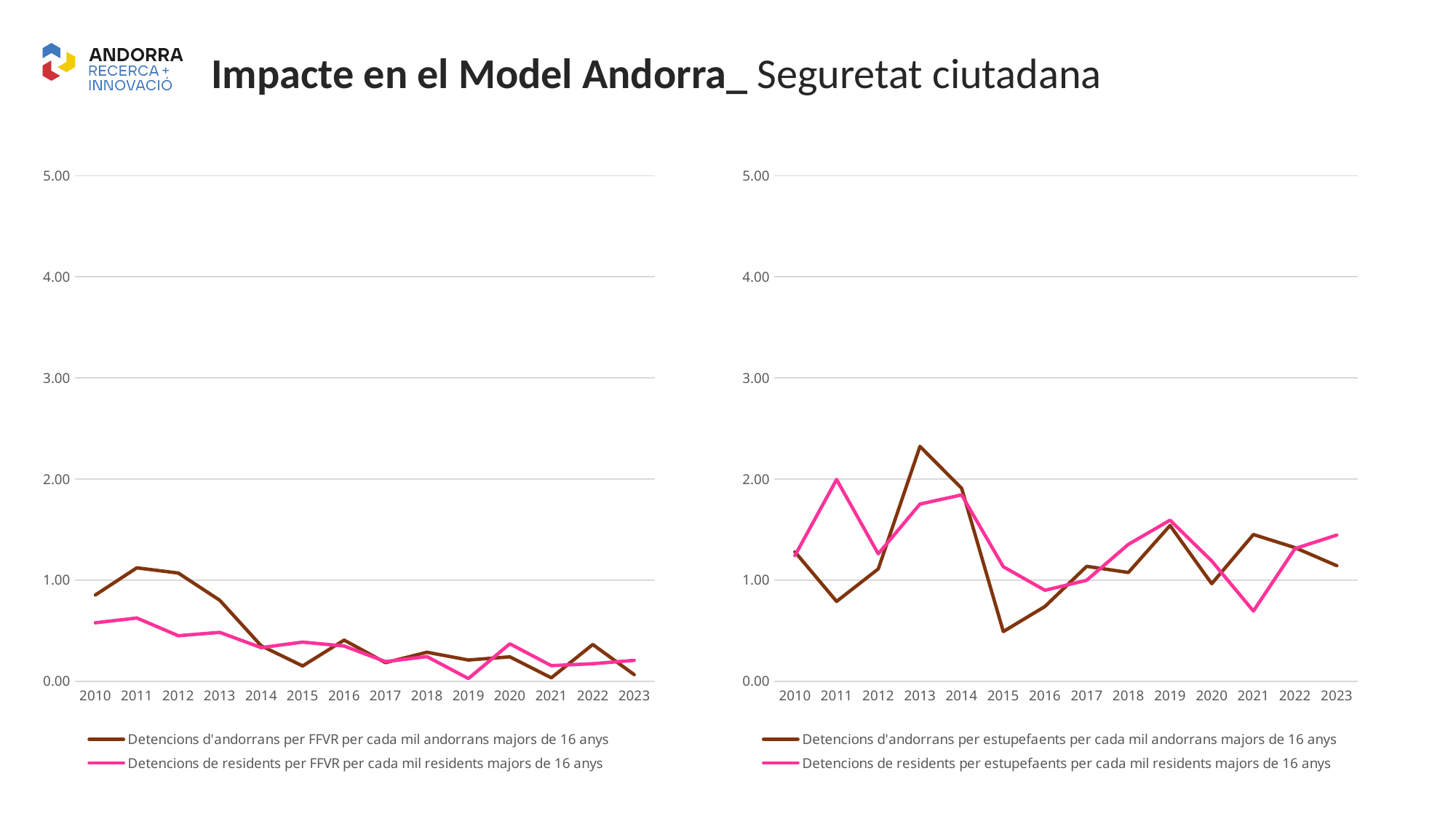
How many series does the legend of the right chart list? 2 In the right chart, is the 2013 value for 'Detencions d'andorrans per estupefaents per cada mil andorrans majors de 16 anys' greater or less than 2.00? greater How many years are plotted along the x axis of the left chart? 14 In the left chart, does the series 'Detencions d'andorrans per FFVR per cada mil andorrans majors de 16 anys' overall rise or fall from 2010 to 2023? fall What kind of chart is the left chart on the slide? line chart In the left chart, in which year does the series 'Detencions d'andorrans per FFVR per cada mil andorrans majors de 16 anys' reach its highest value? 2011 In the left chart, is the 2011 value for 'Detencions d'andorrans per FFVR per cada mil andorrans majors de 16 anys' greater or less than 1.00? greater In the right chart, in which year does the series 'Detencions d'andorrans per estupefaents per cada mil andorrans majors de 16 anys' reach its lowest value? 2015 In the right chart, in which year does the series 'Detencions de residents per estupefaents per cada mil residents majors de 16 anys' reach its lowest value? 2021 In the left chart, in which year does the series 'Detencions de residents per FFVR per cada mil residents majors de 16 anys' reach its lowest value? 2019 In the right chart, which series has the larger value in 2011? Detencions de residents per estupefaents per cada mil residents majors de 16 anys In the right chart, in which year does the series 'Detencions d'andorrans per estupefaents per cada mil andorrans majors de 16 anys' reach its highest value? 2013